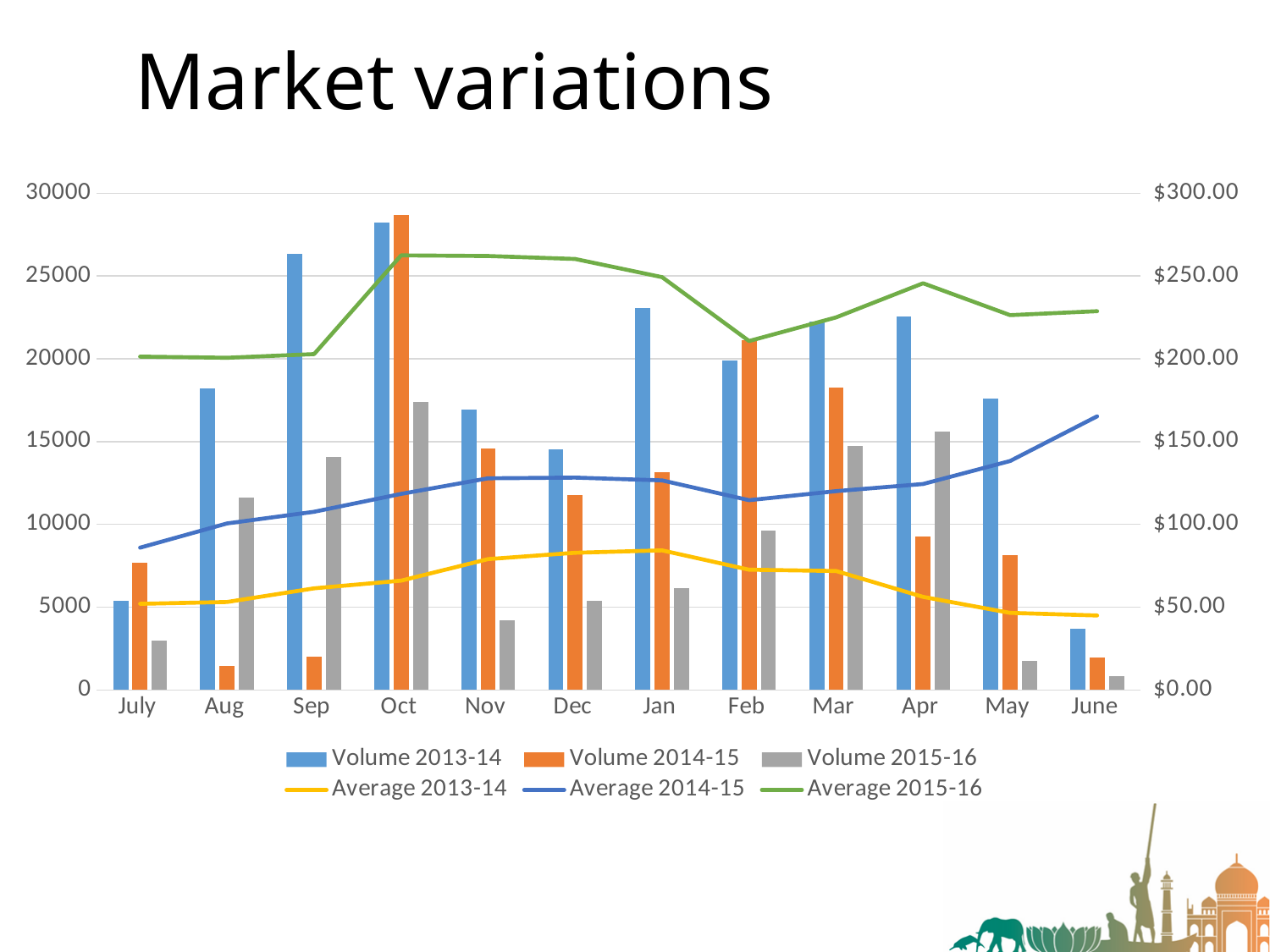
How many series does the legend list? 6 What kind of chart is shown on the slide? A combined bar and line chart In which month is Volume 2013-14 highest? Oct Does Average 2013-14 rise or fall from Jan to June? fall Is the Volume 2013-14 value for Sep greater or less than 25000? greater How many months are shown along the x axis? 12 In which month is Volume 2014-15 highest? Oct What is the title of the slide? Market variations Is the Average 2014-15 value for July greater or less than $100.00? less In which month is Average 2014-15 highest? June In Aug, which is larger: Volume 2013-14 or Volume 2015-16? Volume 2013-14 In which month is Volume 2013-14 lowest? June